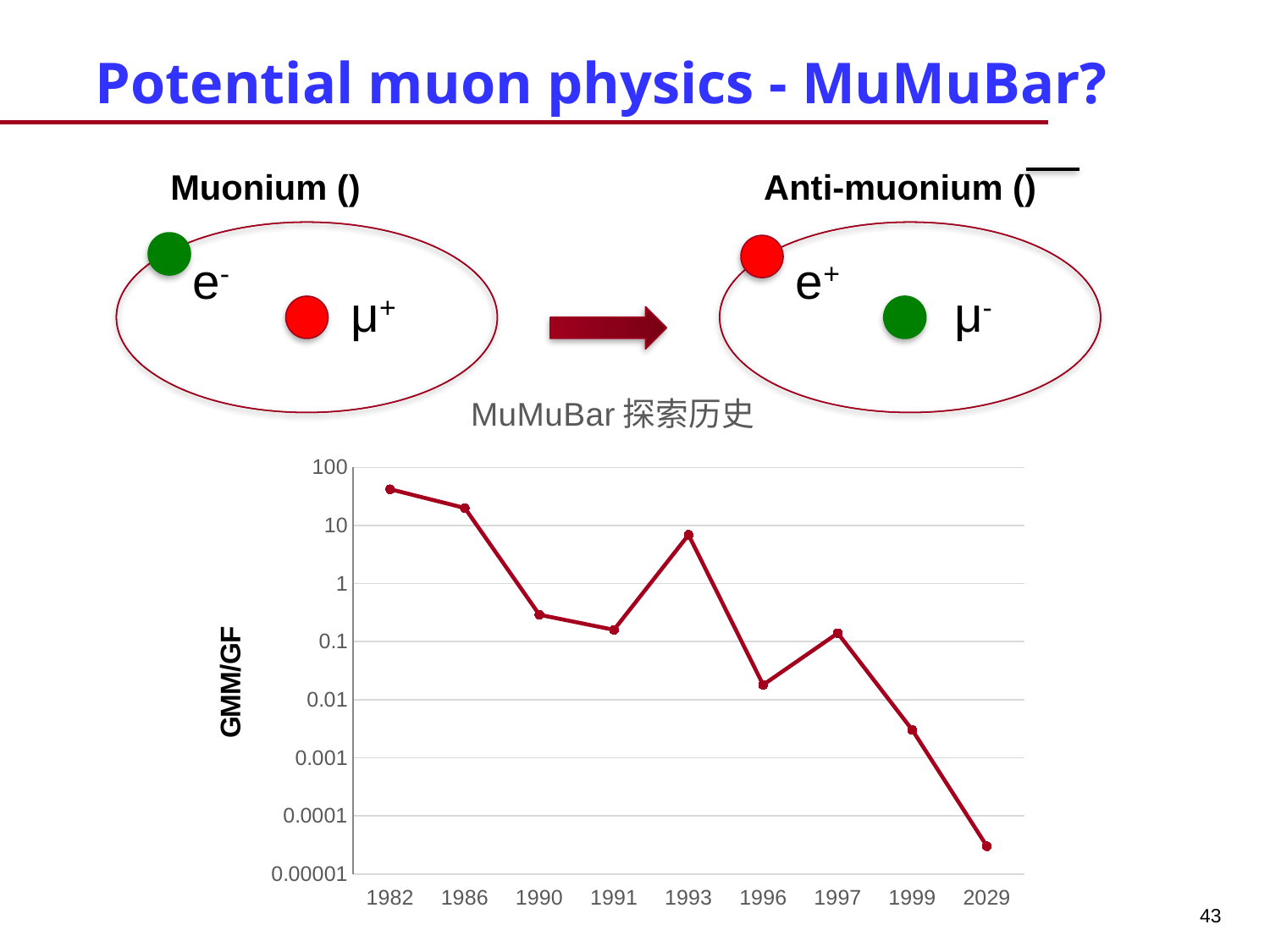
Is the value for 1999 greater or less than 0.01? less Is the value for 1993 greater or less than 1? greater Is the value for 2029 greater or less than 0.0001? less What kind of chart is shown on the slide? line chart Which year has the lowest GMM/GF value on the chart? 2029 Which year has the highest GMM/GF value on the chart? 1982 How many data points are plotted on the line chart? 9 Which has the larger value, 1993 or 1996? 1993 What is the label on the vertical axis of the chart? GMM/GF Do the values generally rise or fall from 1982 to 2029? fall